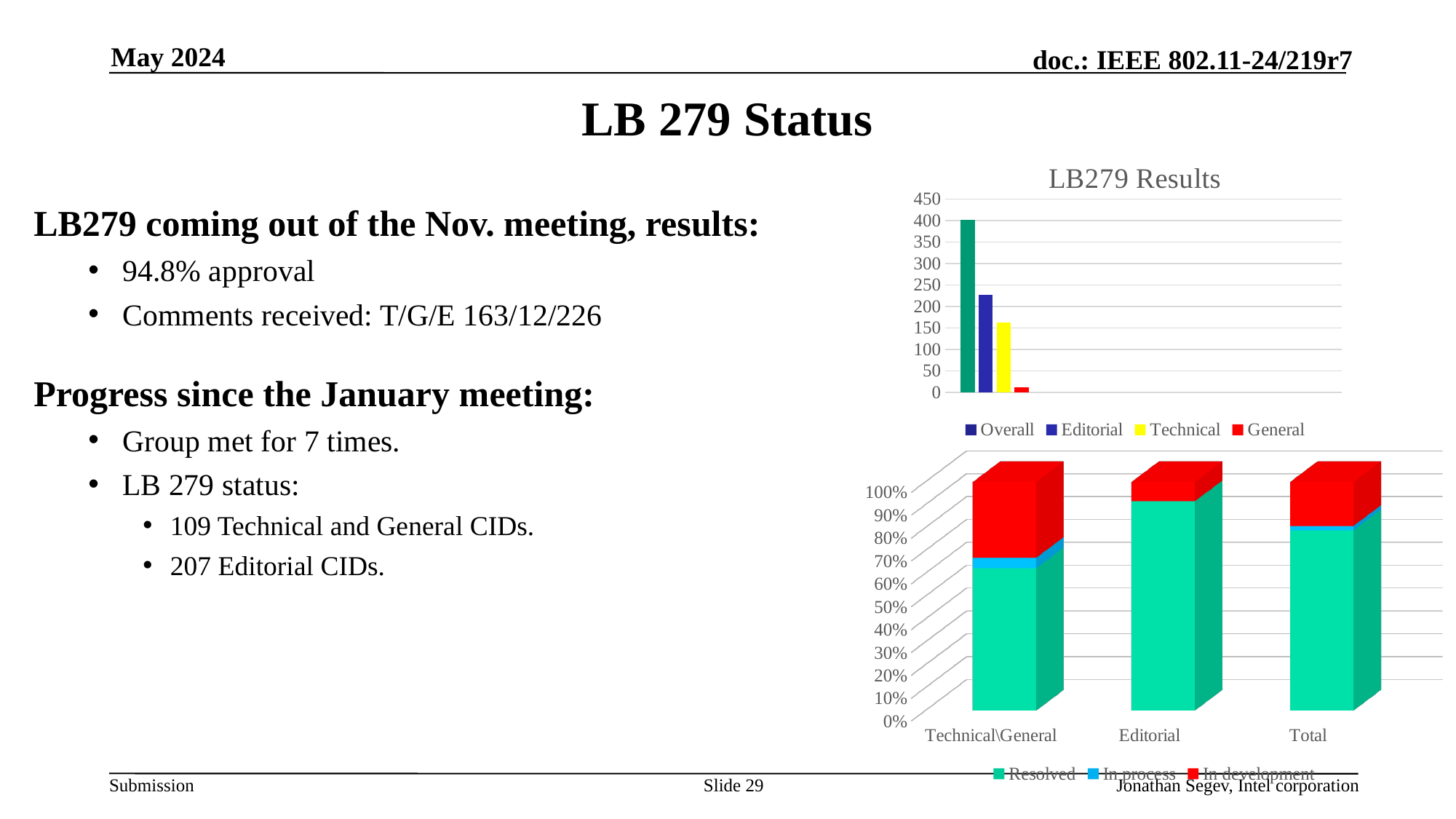
In the top chart "LB279 Results", is the value of the tallest bar greater or less than 350? greater How many categories are shown on the x axis of the bottom stacked bar chart? 3 How many series does the legend of the bottom stacked bar chart list? 3 In the bottom stacked bar chart, is the Resolved share for Editorial greater or less than 90%? greater In the top chart "LB279 Results", what is the highest value shown on the vertical axis? 450 What kind of chart is the bottom chart with categories Technical\General, Editorial and Total? stacked bar chart How many series does the legend of the top chart "LB279 Results" list? 4 In the bottom stacked bar chart, is the Resolved share for Technical\General greater or less than 70%? less What kind of chart is the top chart titled "LB279 Results"? bar chart In the bottom stacked bar chart, which category has the larger Resolved share, Technical\General or Editorial? Editorial How many bars are plotted in the top chart "LB279 Results"? 4